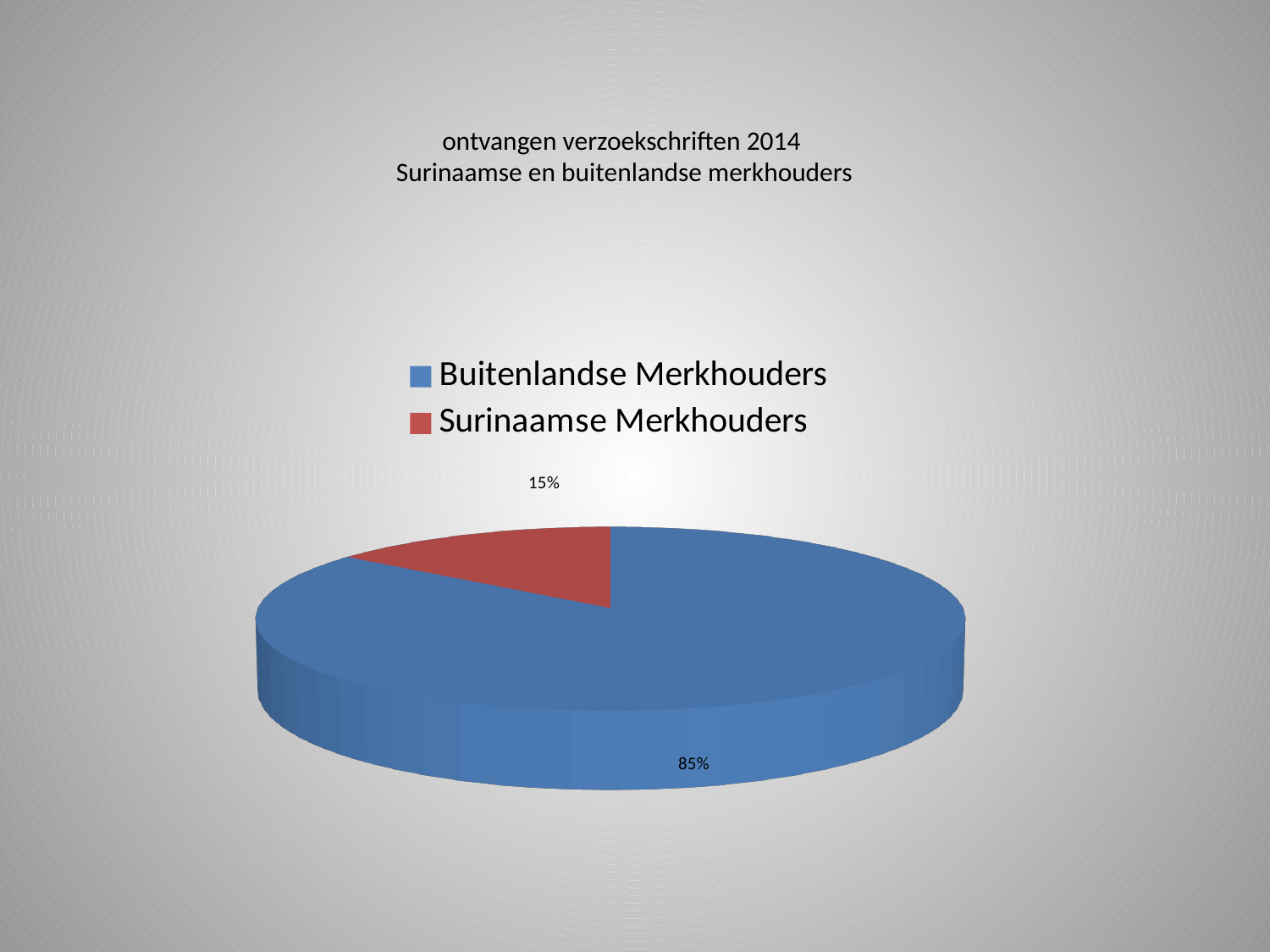
What is the title of the chart? ontvangen verzoekschriften 2014 Surinaamse en buitenlandse merkhouders What share of the pie does Buitenlandse Merkhouders represent? 85% How many slices does the pie chart have? 2 What colour is the slice for Surinaamse Merkhouders? Red Which is larger, the slice for Buitenlandse Merkhouders or the slice for Surinaamse Merkhouders? Buitenlandse Merkhouders Which category has the largest slice of the pie? Buitenlandse Merkhouders What share of the pie does Surinaamse Merkhouders represent? 15% How many entries does the legend list? 2 What is the difference in percentage points between the Buitenlandse Merkhouders and Surinaamse Merkhouders slices? 70 What kind of chart is shown on the slide? Pie chart Which category has the smallest slice of the pie? Surinaamse Merkhouders